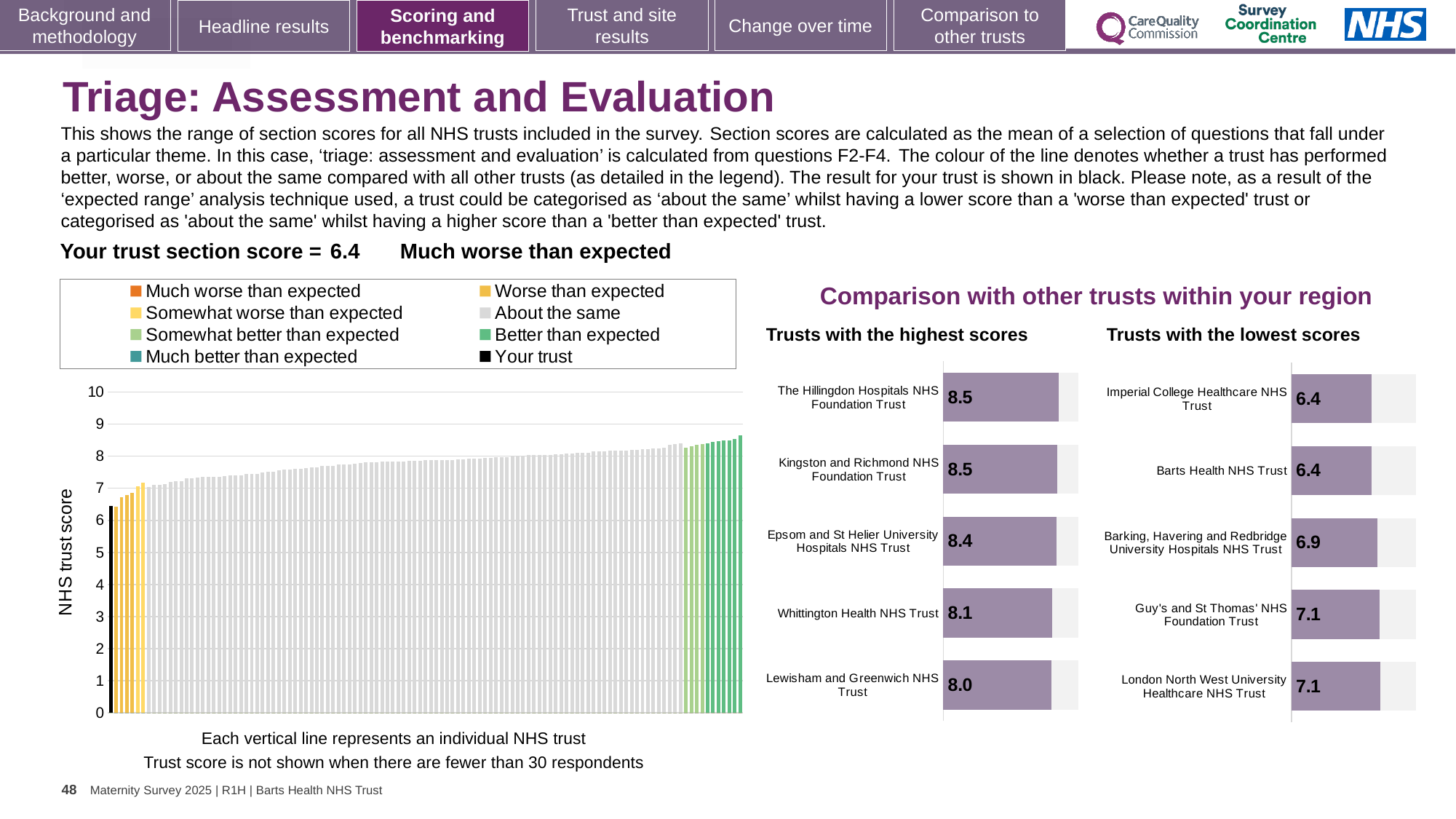
In the 'Trusts with the lowest scores' chart, what is the score for Barts Health NHS Trust? 6.4 In the 'Trusts with the highest scores' chart, which trust has the lowest score? Lewisham and Greenwich NHS Trust In the 'Trusts with the lowest scores' chart, what is the score for Barking, Havering and Redbridge University Hospitals NHS Trust? 6.9 In the 'Trusts with the highest scores' chart, what is the score for Epsom and St Helier University Hospitals NHS Trust? 8.4 How many entries does the legend of the large chart on the left list? 8 What kind of chart is the large chart on the left showing NHS trust scores? Bar chart In the 'Trusts with the highest scores' chart, what is the score for Whittington Health NHS Trust? 8.1 In the 'Trusts with the lowest scores' chart, what is the difference between the scores of Barking, Havering and Redbridge University Hospitals NHS Trust and Imperial College Healthcare NHS Trust? 0.5 How many trusts are shown in the 'Trusts with the highest scores' chart? 5 In the 'Trusts with the highest scores' chart, what is the difference between the scores of The Hillingdon Hospitals NHS Foundation Trust and Lewisham and Greenwich NHS Trust? 0.5 In the 'Trusts with the lowest scores' chart, which has the larger score: Barking, Havering and Redbridge University Hospitals NHS Trust or Guy's and St Thomas' NHS Foundation Trust? Guy's and St Thomas' NHS Foundation Trust In the large chart on the left, do the trust scores rise or fall from left to right? Rise